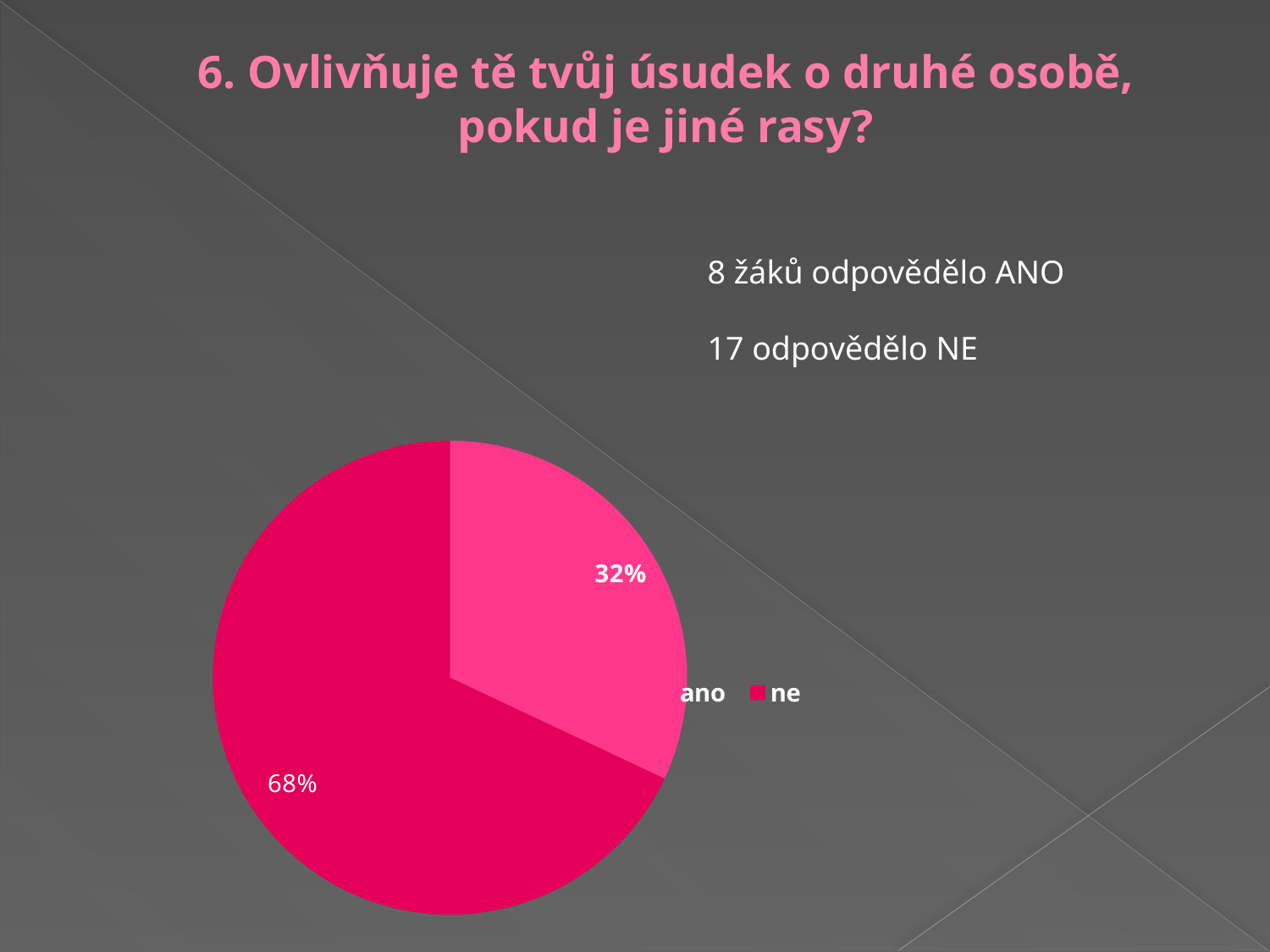
Which is larger, the "ano" slice or the "ne" slice? ne How many entries does the legend list? 2 What kind of chart is shown on the slide? pie chart Which slice of the pie is the smallest? ano What are the two legend entries of the pie chart? ano, ne What share of the pie does the "ne" slice represent? 68% What share of the pie does the "ano" slice represent? 32% What is the difference in percentage points between the "ne" slice and the "ano" slice? 36 How many slices does the pie chart have? 2 Which slice of the pie is the largest? ne Is the share of the "ne" slice greater or less than 50%? greater